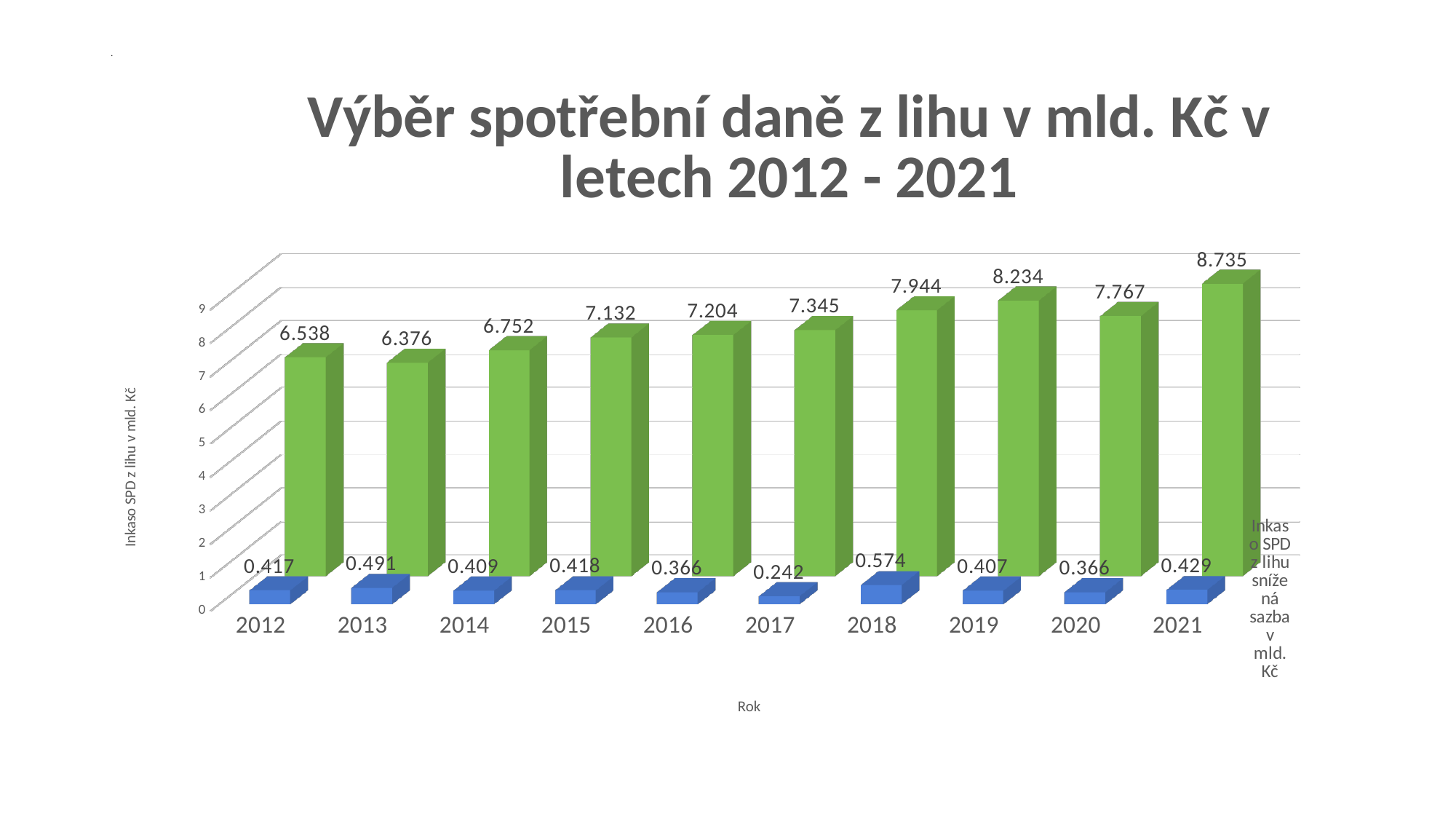
How many years are shown on the x axis? 10 Which year has the lowest green bar? 2013 What is the value of the blue bar for 2017? 0.242 What is the value of the green bar for 2021? 8.735 Is the green bar for 2019 larger or smaller than the green bar for 2020? larger Which year has the lowest blue bar? 2017 What is the difference between the green bar values for 2021 and 2020? 0.968 What type of chart is shown on the slide? bar chart Which year has the highest blue bar? 2018 Which year has the highest green bar? 2021 What is the label of the x axis? Rok What is the value of the green bar for 2015? 7.132